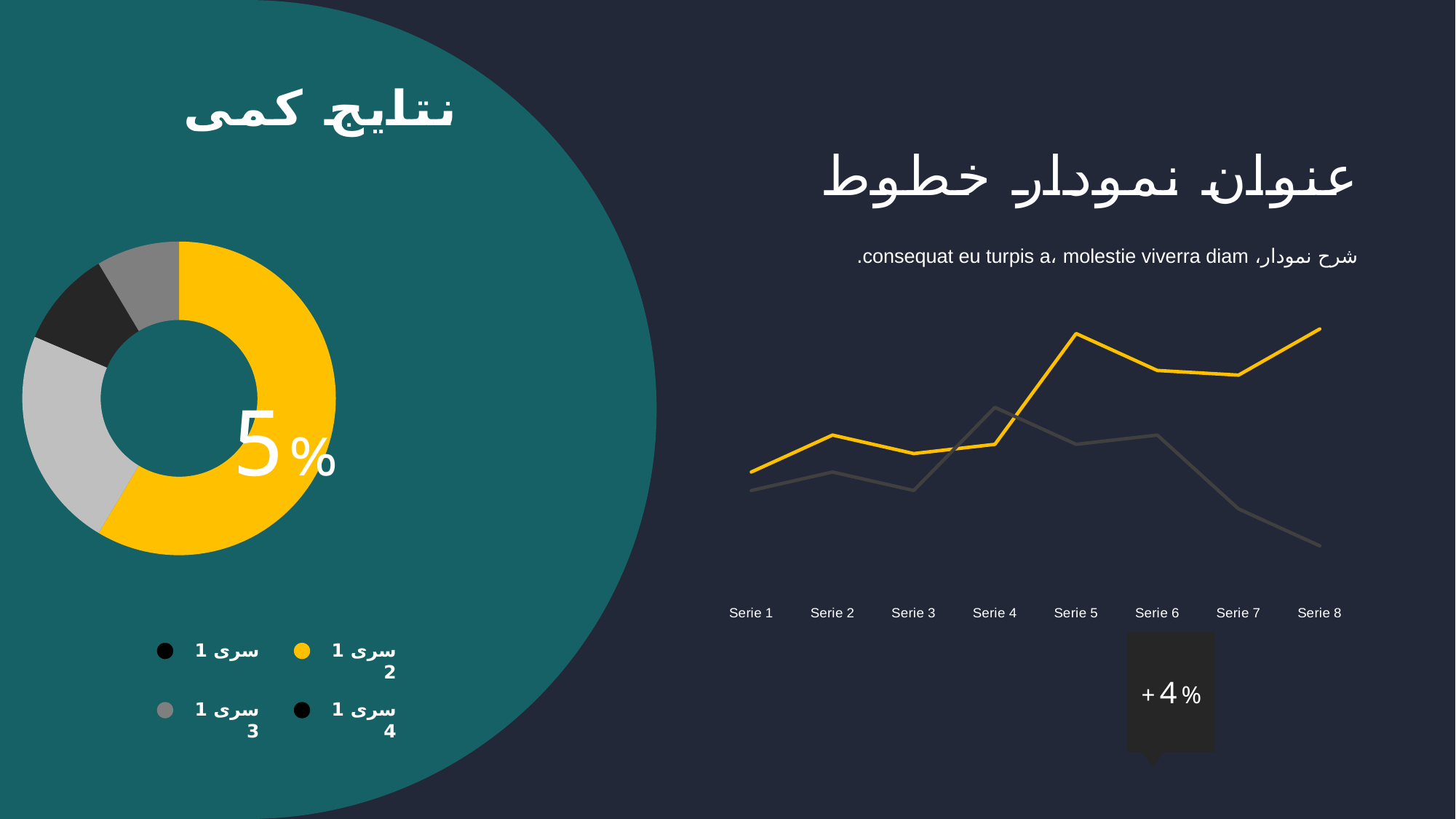
In the doughnut chart on the left, which colour is the largest slice? yellow In the line chart on the right, is the yellow line higher at Serie 5 or at Serie 3? Serie 5 What kind of chart is shown on the right side of the slide under the title "عنوان نمودار خطوط"? line chart In the line chart on the right, at which category does the gray line reach its lowest point? Serie 8 In the line chart on the right, how many lines are plotted? 2 In the line chart on the right, does the yellow line rise or fall from Serie 4 to Serie 5? rise In the doughnut chart on the left, how many entries does the legend list? 4 In the line chart on the right, at which category does the yellow line reach its lowest point? Serie 1 In the line chart on the right, at which category does the gray line reach its highest point? Serie 4 In the line chart on the right, how many categories are shown on the x axis? 8 What kind of chart is shown on the left side of the slide under the title "نتایج کمی"? doughnut chart In the line chart on the right, does the gray line rise or fall from Serie 6 to Serie 8? fall